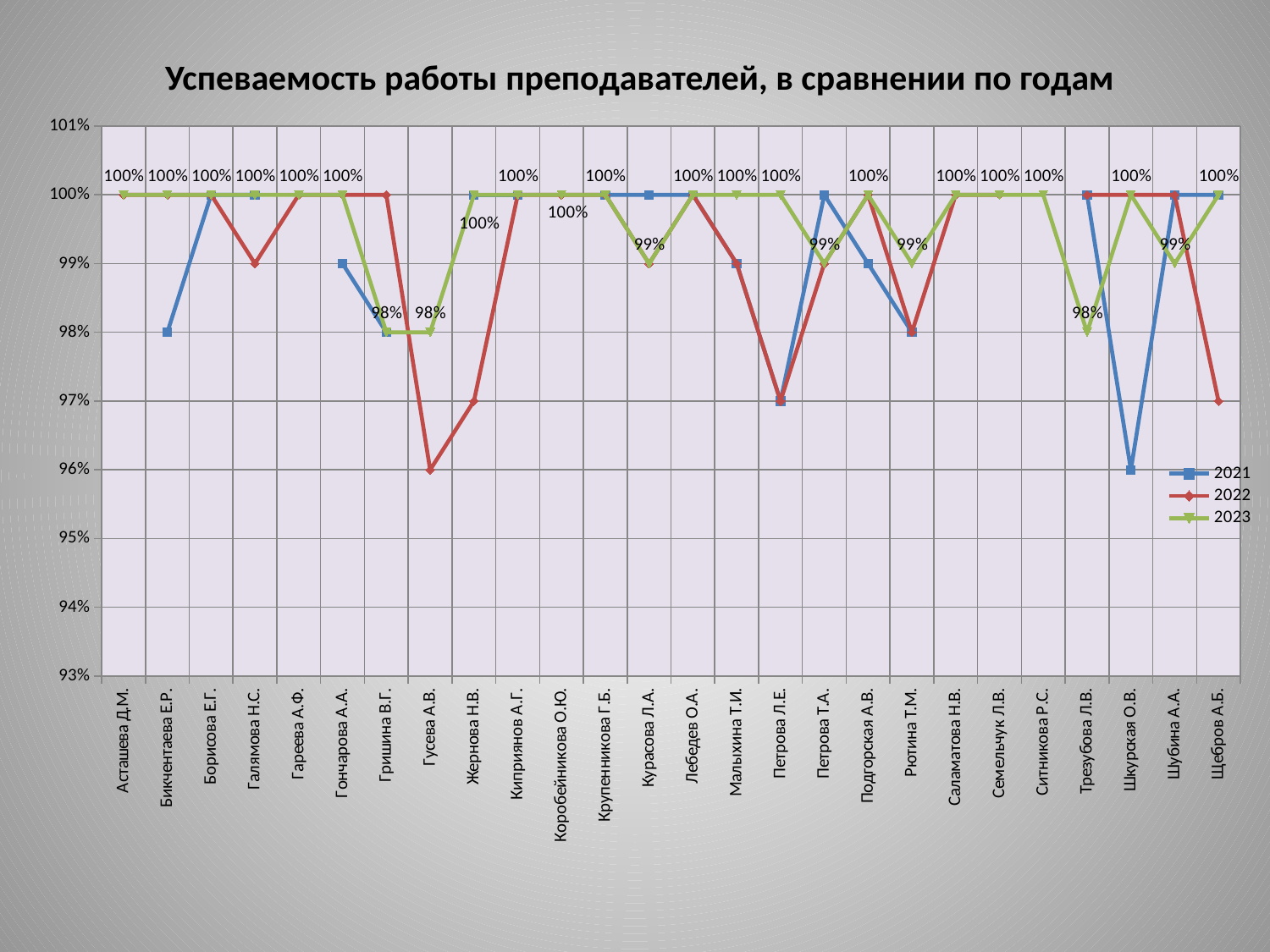
Which teacher has the lowest 2021 value? Шкурская О.В. Which teacher has the lowest 2022 value? Гусева А.В. What is the 2023 value for Курасова Л.А.? 99% Which is larger, the 2023 value for Гришина В.Г. or the 2023 value for Курасова Л.А.? Курасова Л.А. How many teachers (categories) are shown on the x axis? 26 What kind of chart is shown on the slide? line chart What is the difference between the 2023 value for Щебров А.Б. and the 2023 value for Трезубова Л.В.? 2% What is the 2023 value for Трезубова Л.В.? 98% How many series does the legend list? 3 What is the title of the chart? Успеваемость работы преподавателей, в сравнении по годам What is the 2023 value for Гришина В.Г.? 98% Is the 2022 value for Щебров А.Б. greater or less than 98%? less